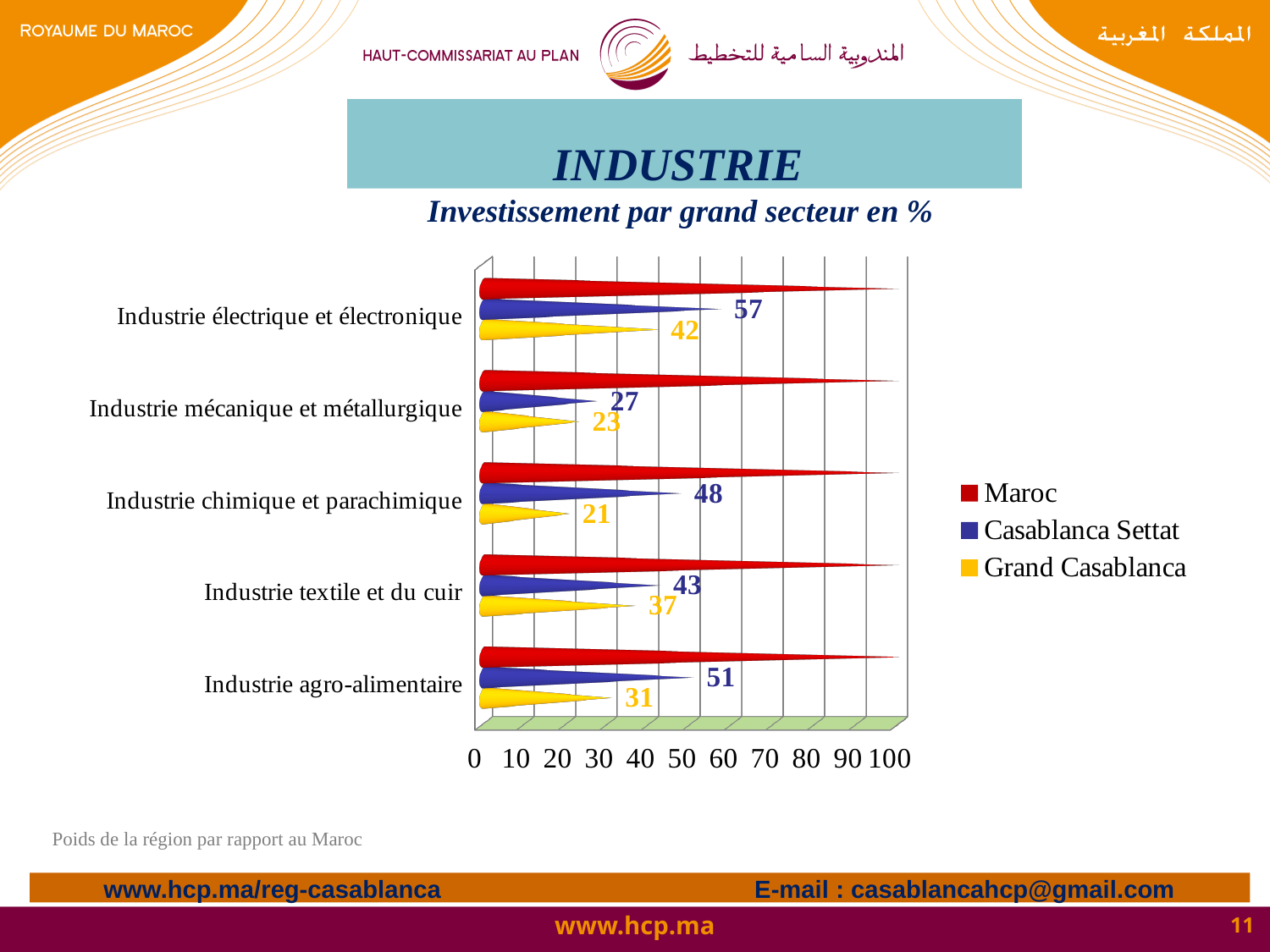
What kind of chart is shown on the slide? Bar chart What is the Casablanca Settat value for Industrie agro-alimentaire? 51 Is the Maroc value for Industrie agro-alimentaire greater or less than 90? greater What is the Casablanca Settat value for Industrie électrique et électronique? 57 What is the difference between the Casablanca Settat and Grand Casablanca values for Industrie textile et du cuir? 6 Which sector has the lowest Grand Casablanca value? Industrie chimique et parachimique Which is larger for Industrie mécanique et métallurgique: the Casablanca Settat value or the Grand Casablanca value? Casablanca Settat How many series does the legend list? 3 Which sector has the highest Casablanca Settat value? Industrie électrique et électronique Which series is shown in yellow in the legend? Grand Casablanca How many sectors are shown on the chart? 5 What is the Grand Casablanca value for Industrie chimique et parachimique? 21